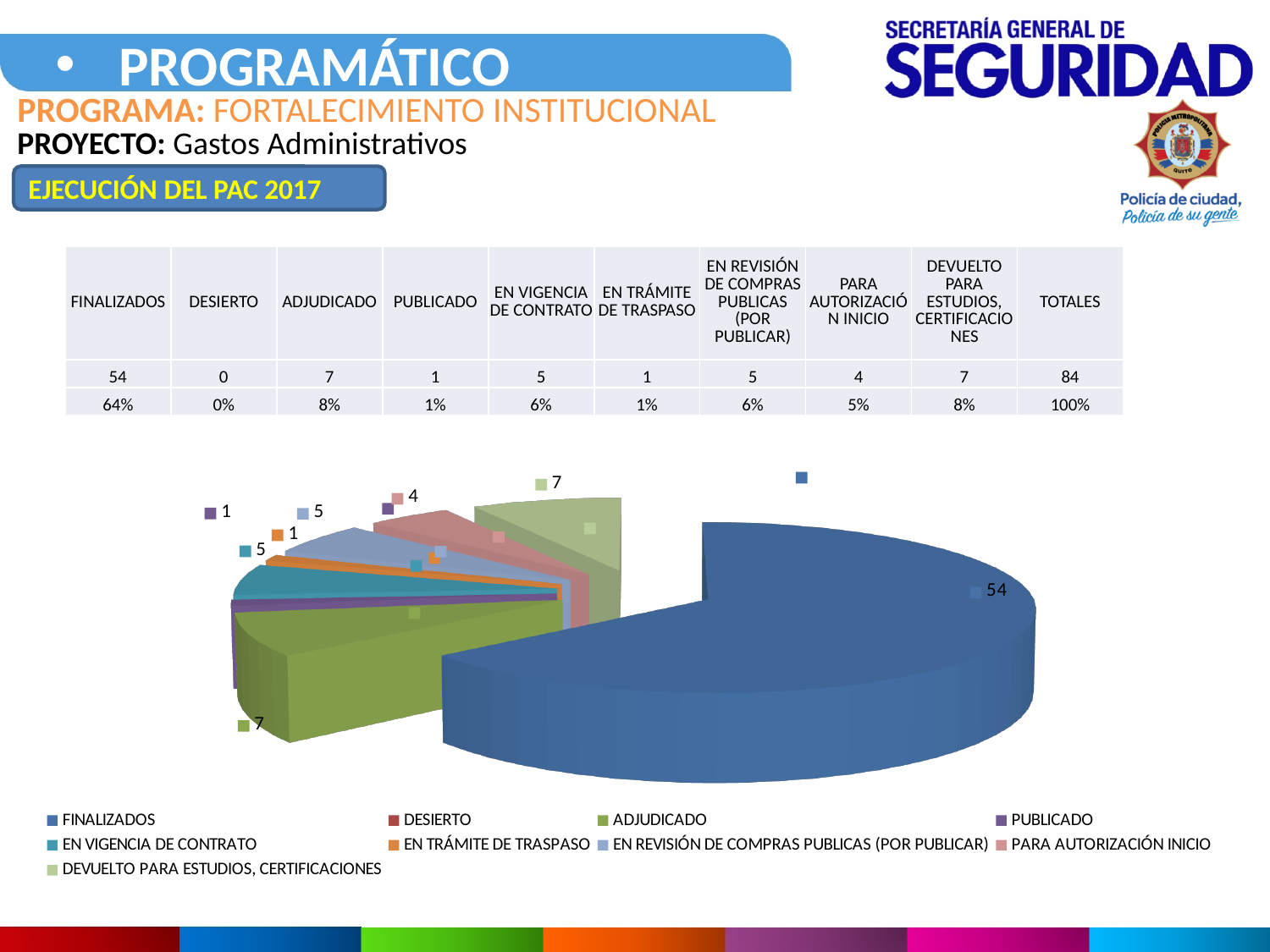
What is the value of the PARA AUTORIZACIÓN INICIO slice in the pie chart? 4 Which category has the largest slice in the pie chart? FINALIZADOS What is the value of the ADJUDICADO slice in the pie chart? 7 How many entries does the pie chart legend list? 9 What is the total of all the values shown in the pie chart? 84 What is the difference between the FINALIZADOS value and the DEVUELTO PARA ESTUDIOS, CERTIFICACIONES value in the pie chart? 47 What type of chart is shown on the slide? pie chart Which is larger in the pie chart, the ADJUDICADO slice or the PARA AUTORIZACIÓN INICIO slice? ADJUDICADO What share of the pie does the FINALIZADOS slice represent? 64% What is the value of the FINALIZADOS slice in the pie chart? 54 What is the value of the EN VIGENCIA DE CONTRATO slice in the pie chart? 5 What colour is the FINALIZADOS slice in the pie chart? blue